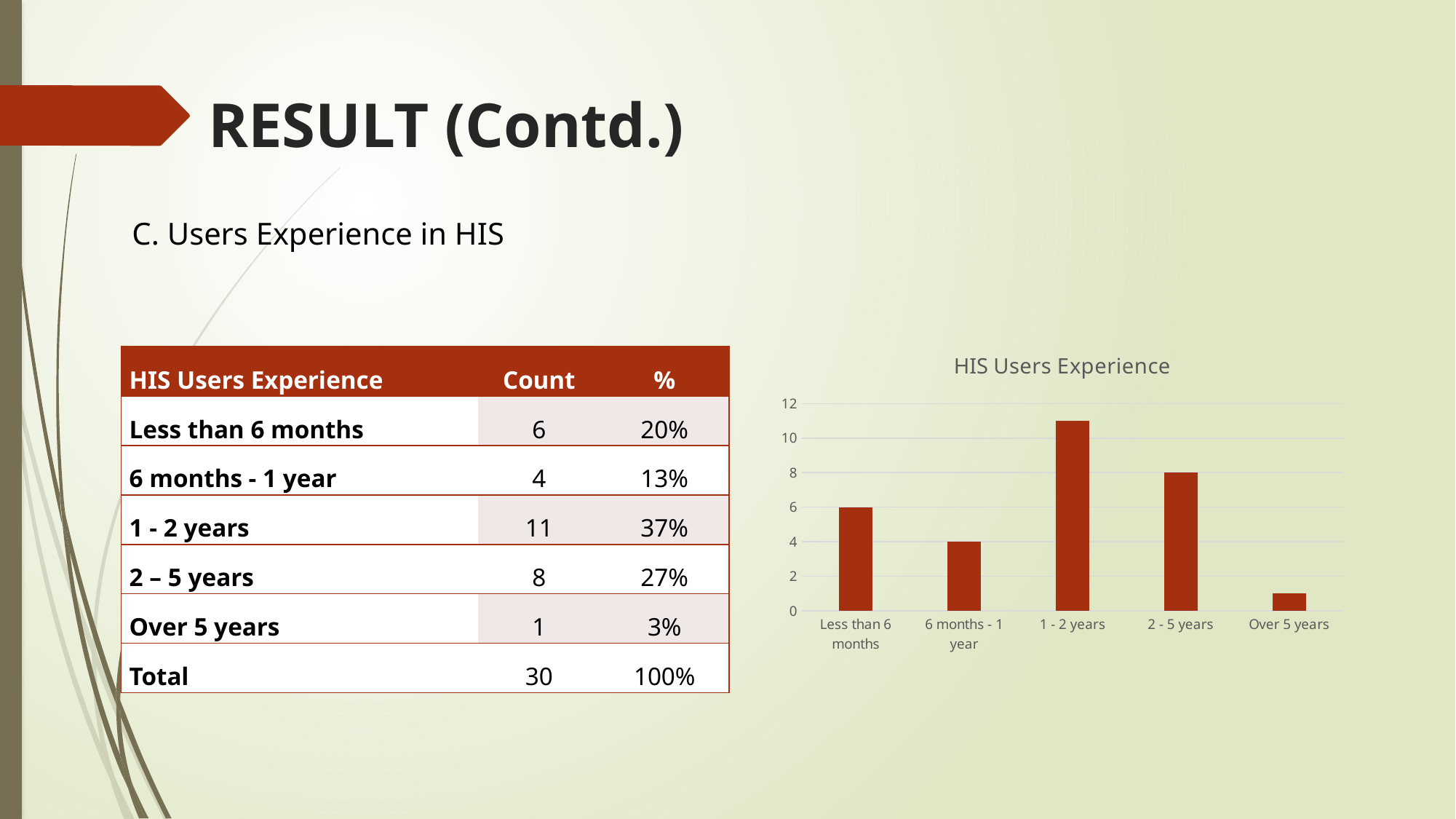
What is the difference between the values for 2 - 5 years and Less than 6 months? 2 Is the value for Over 5 years greater or less than 2? less What is the value for Less than 6 months in the chart? 6 What is the value for 2 - 5 years in the chart? 8 Which category has the lowest bar in the chart? Over 5 years What is the value for 6 months - 1 year in the chart? 4 What type of chart is shown on the slide? Bar chart Which is larger in the chart, the value for Less than 6 months or the value for 6 months - 1 year? Less than 6 months What is the title of the chart? HIS Users Experience How many categories are shown on the x axis of the chart? 5 Is the value for 1 - 2 years greater or less than 10? greater Which category has the highest bar in the chart? 1 - 2 years